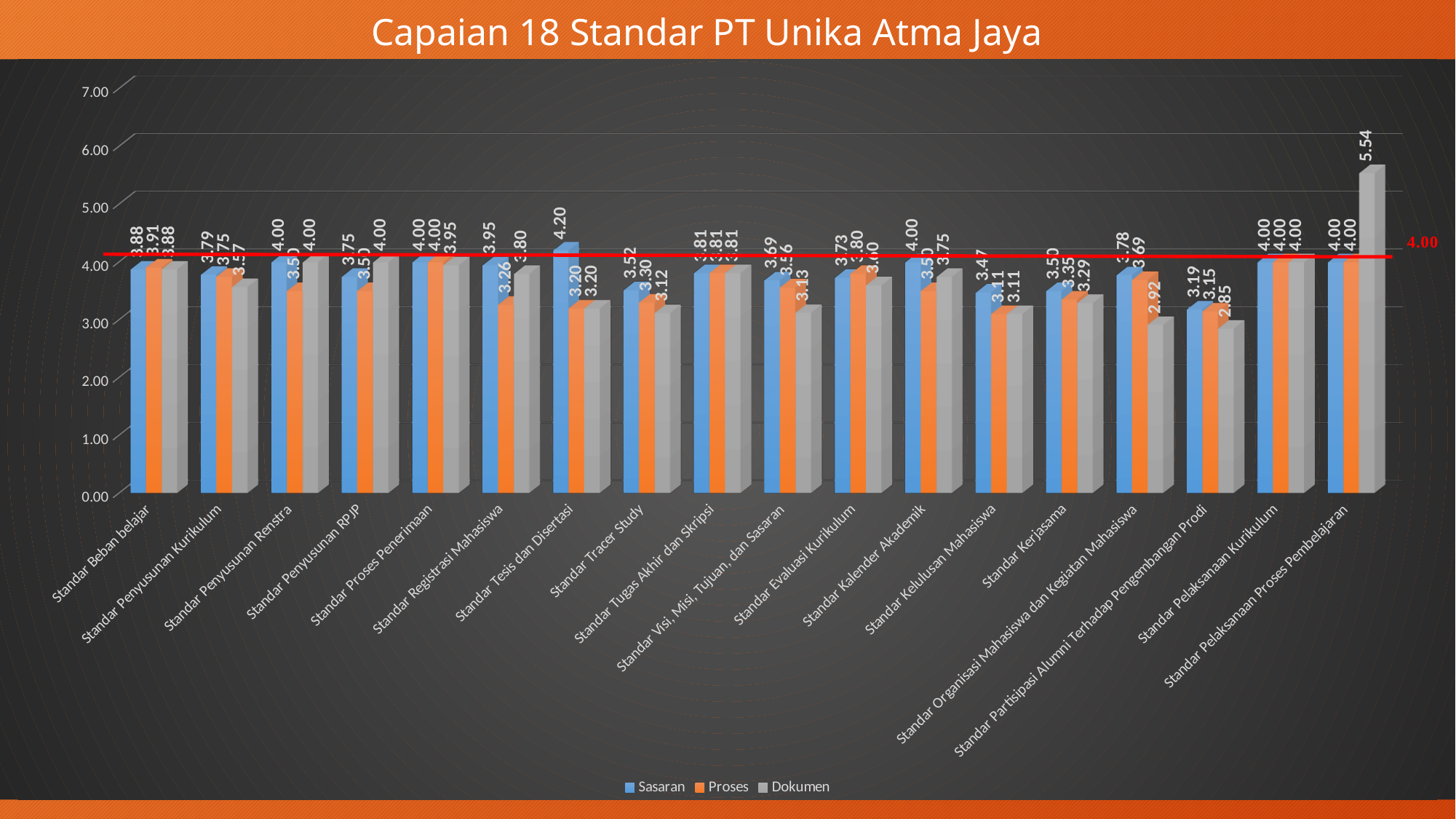
What is the Sasaran value for Standar Tesis dan Disertasi? 4.20 Which standard has the lowest Dokumen value? Standar Partisipasi Alumni Terhadap Pengembangan Prodi How many series does the legend list? 3 Which standard has the highest Dokumen value? Standar Pelaksanaan Proses Pembelajaran Which has the larger Dokumen value, Standar Kelulusan Mahasiswa or Standar Kerjasama? Standar Kerjasama What is the Proses value for Standar Tracer Study? 3.30 How many standards (categories) are plotted along the x axis? 18 What is the difference between the Sasaran and Proses values for Standar Tesis dan Disertasi? 1.00 What kind of chart is shown on the slide? bar chart What is the Sasaran value for Standar Kelulusan Mahasiswa? 3.47 What is the Dokumen value for Standar Pelaksanaan Proses Pembelajaran? 5.54 What value does the red horizontal reference line mark? 4.00